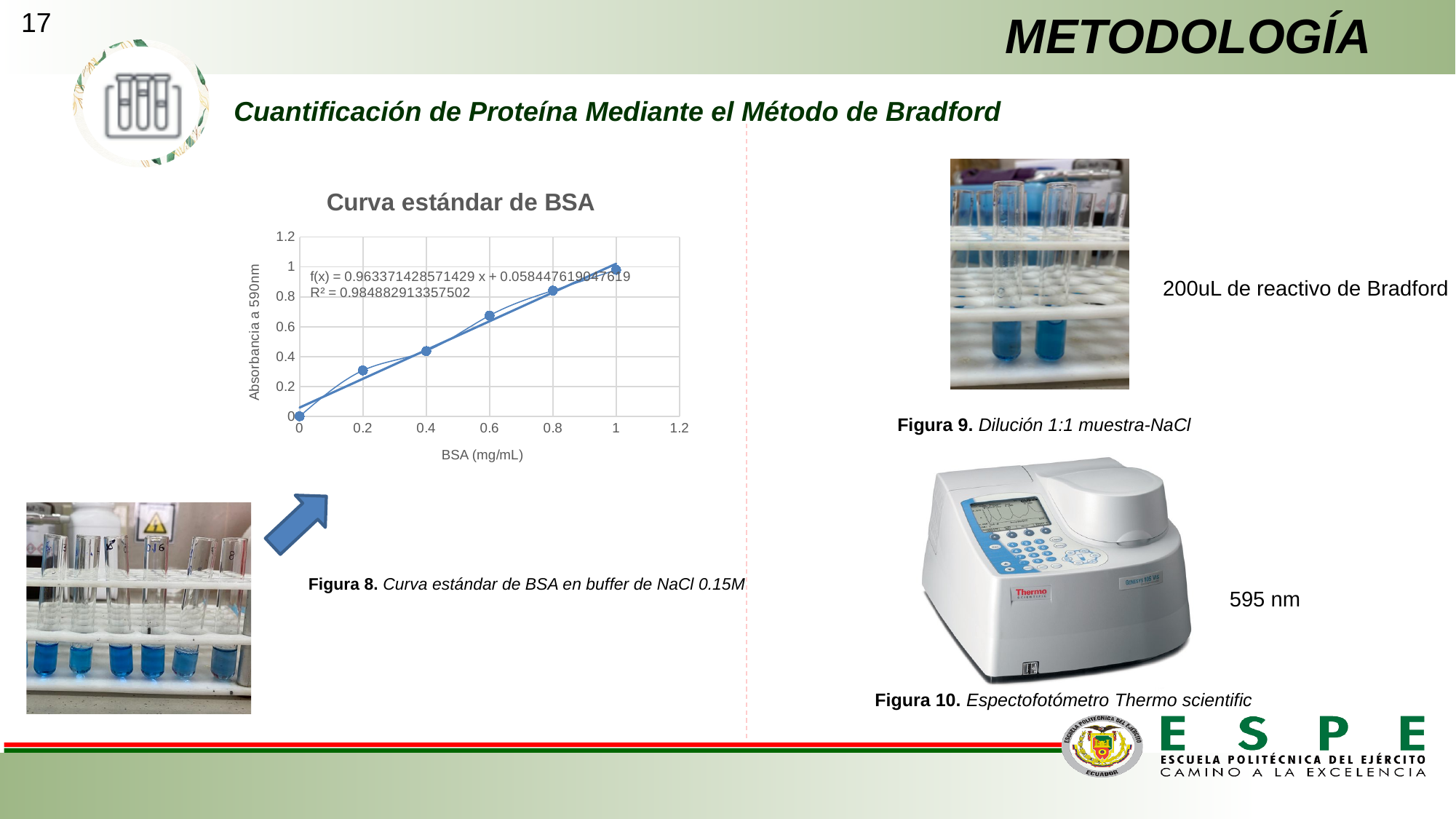
Is the absorbance at 0.2 mg/mL BSA greater or less than 0.4? less What is the title of the chart on the slide? Curva estándar de BSA What R² value is printed on the chart? 0.984882913357502 Is the absorbance at 0.6 mg/mL BSA greater or less than 0.8? less At which BSA concentration is the absorbance lowest? 0 At which BSA concentration is the absorbance highest? 1 What kind of chart is "Curva estándar de BSA"? line chart with markers (scatter) Which has the higher absorbance: 0.8 mg/mL BSA or 0.4 mg/mL BSA? 0.8 mg/mL Is the absorbance at 1 mg/mL BSA greater or less than 0.8? greater What is the label of the y axis of the chart? Absorbancia a 590nm Does the absorbance rise or fall as BSA concentration increases along the x axis? rise How many data points are plotted in the "Curva estándar de BSA" chart? 6